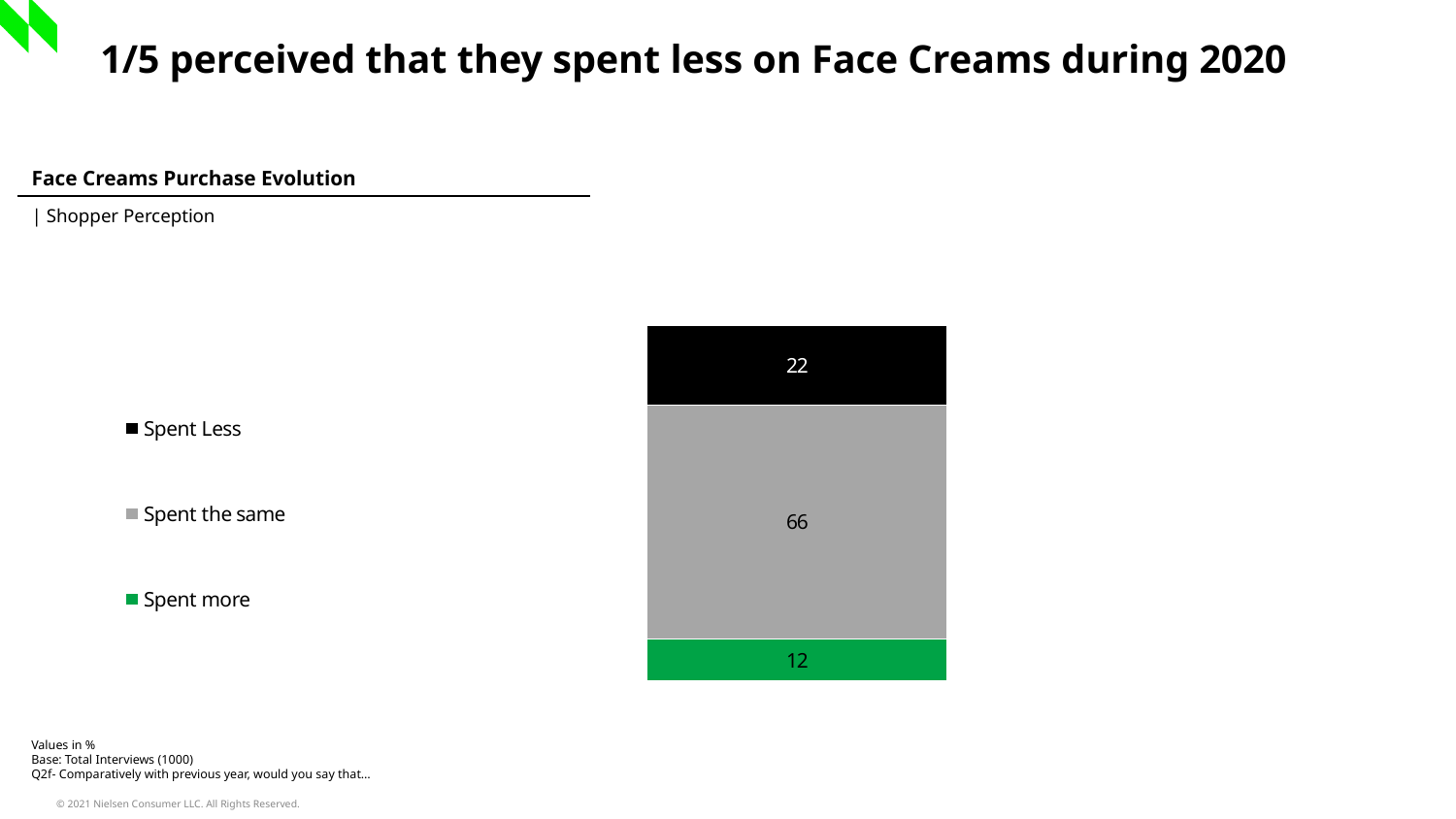
Which colour represents 'Spent more' in the chart? Green What percentage of shoppers said they spent less on face creams? 22 What value is shown for the 'Spent more' segment? 12 What is the total of the three segments in the stacked bar? 100 How many series does the legend list? 3 What is the difference between the 'Spent the same' and 'Spent Less' values? 44 Which is larger, 'Spent Less' or 'Spent more'? Spent Less What is the difference between the 'Spent Less' and 'Spent more' values? 10 Which segment has the largest value in the stacked bar? Spent the same What value is shown for the 'Spent the same' segment? 66 Which segment has the smallest value in the stacked bar? Spent more What kind of chart is shown on the slide? Stacked bar chart